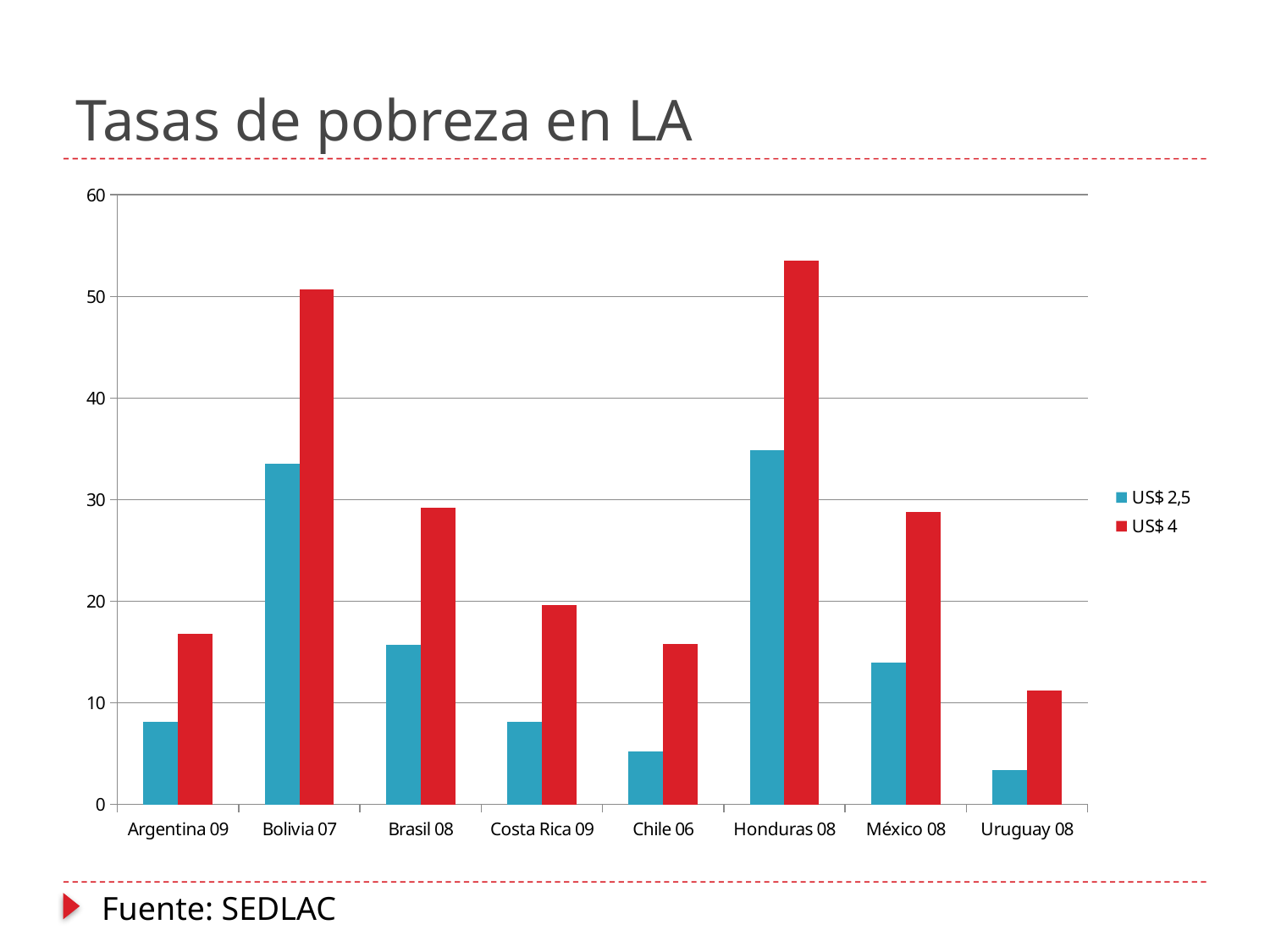
Which country has the lowest US$ 2,5 poverty rate? Uruguay 08 Which country has the highest US$ 4 poverty rate? Honduras 08 What kind of chart is shown on the slide? bar chart Is the US$ 4 value for Bolivia 07 greater or less than 40? greater Which country has the lowest US$ 4 poverty rate? Uruguay 08 Is the US$ 2,5 value for Chile 06 greater or less than 10? less What is the title of the chart? Tasas de pobreza en LA Is the US$ 2,5 value for México 08 greater or less than 10? greater How many series does the legend list? 2 Which is larger, the US$ 2,5 value for Bolivia 07 or for Brasil 08? Bolivia 07 How many countries are shown on the x axis? 8